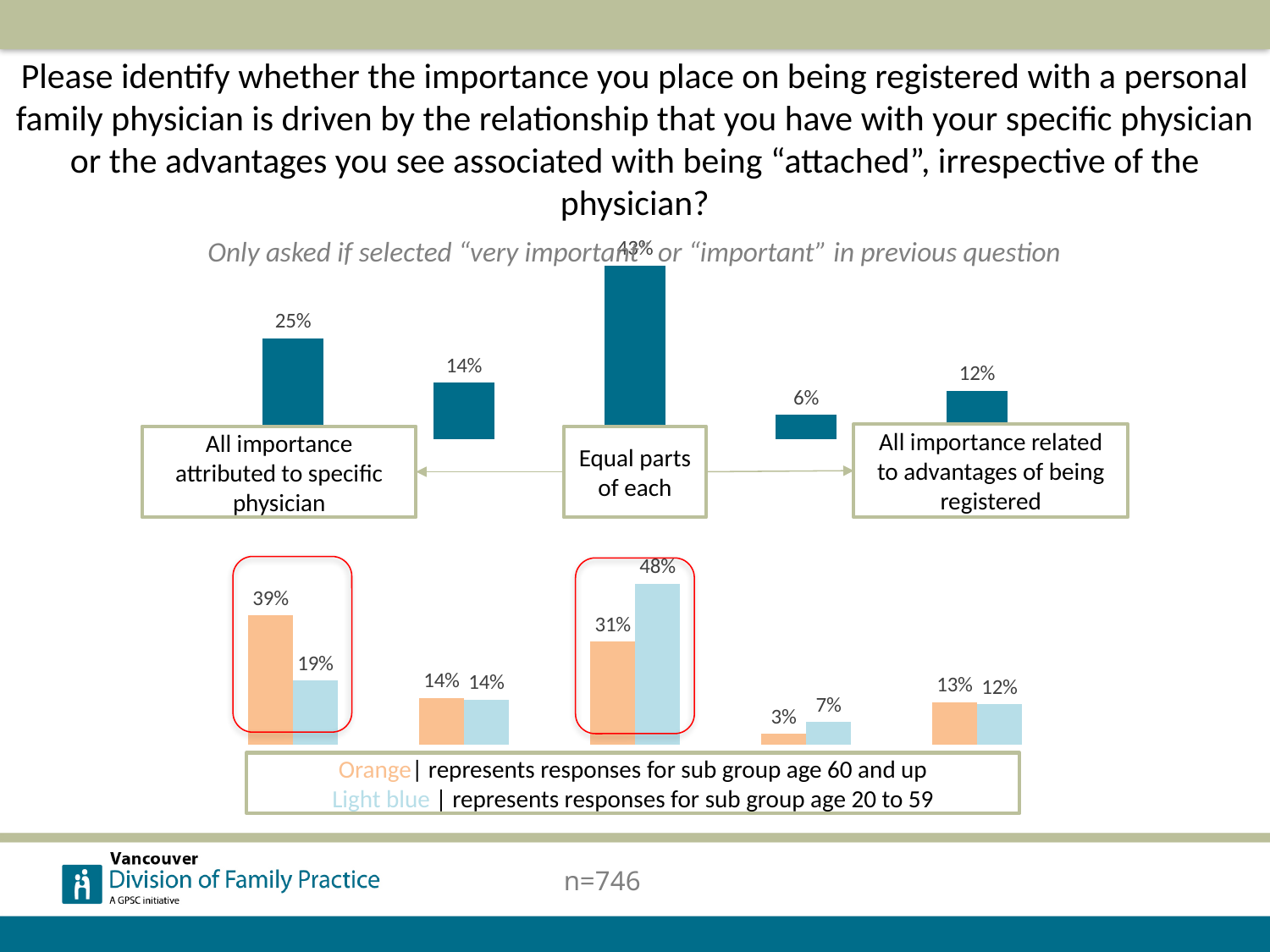
In the top chart, what is the value for 'All importance related to advantages of being registered'? 12% How many bars are in the top chart? 5 In the bottom chart, what is the difference between the light blue and orange values in the middle group? 17 percentage points In the top chart, which labelled category has the tallest bar? Equal parts of each In the top chart, what is the value for 'All importance attributed to specific physician'? 25% In the bottom chart, what is the difference between the orange and light blue values in the leftmost group? 20 percentage points What kind of chart is the bottom chart? Bar chart In the top chart, what is the value of the lowest bar? 6% In the bottom chart, what is the orange value for the leftmost group (all importance attributed to specific physician)? 39% In the bottom chart, what is the lowest value shown? 3% In the bottom chart, what is the light blue value for the middle group (equal parts of each)? 48% In the bottom chart, which colour represents responses for the sub group age 60 and up? Orange